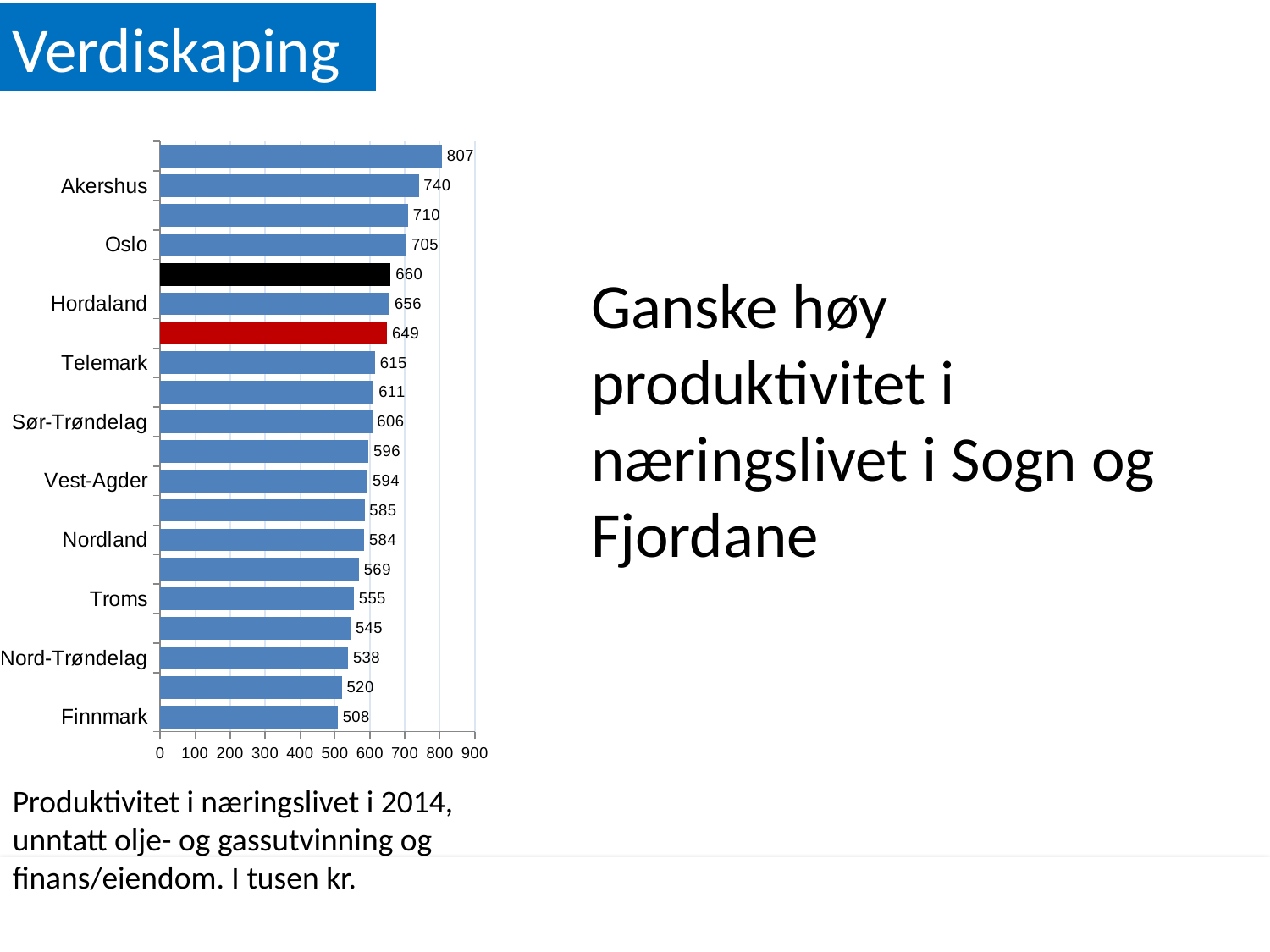
What kind of chart is shown on the slide? Bar chart How many bars are plotted on the chart? 20 What is the value for Finnmark? 508 Which labelled category has the lowest value? Finnmark What is the difference between the values for Akershus and Oslo? 35 What is the highest value shown on the chart? 807 What is the value for Oslo? 705 What is the value for Hordaland? 656 What is the value of the red bar? 649 What is the value for Akershus? 740 What is the value for Troms? 555 Which is larger, the value for Telemark or the value for Nordland? Telemark